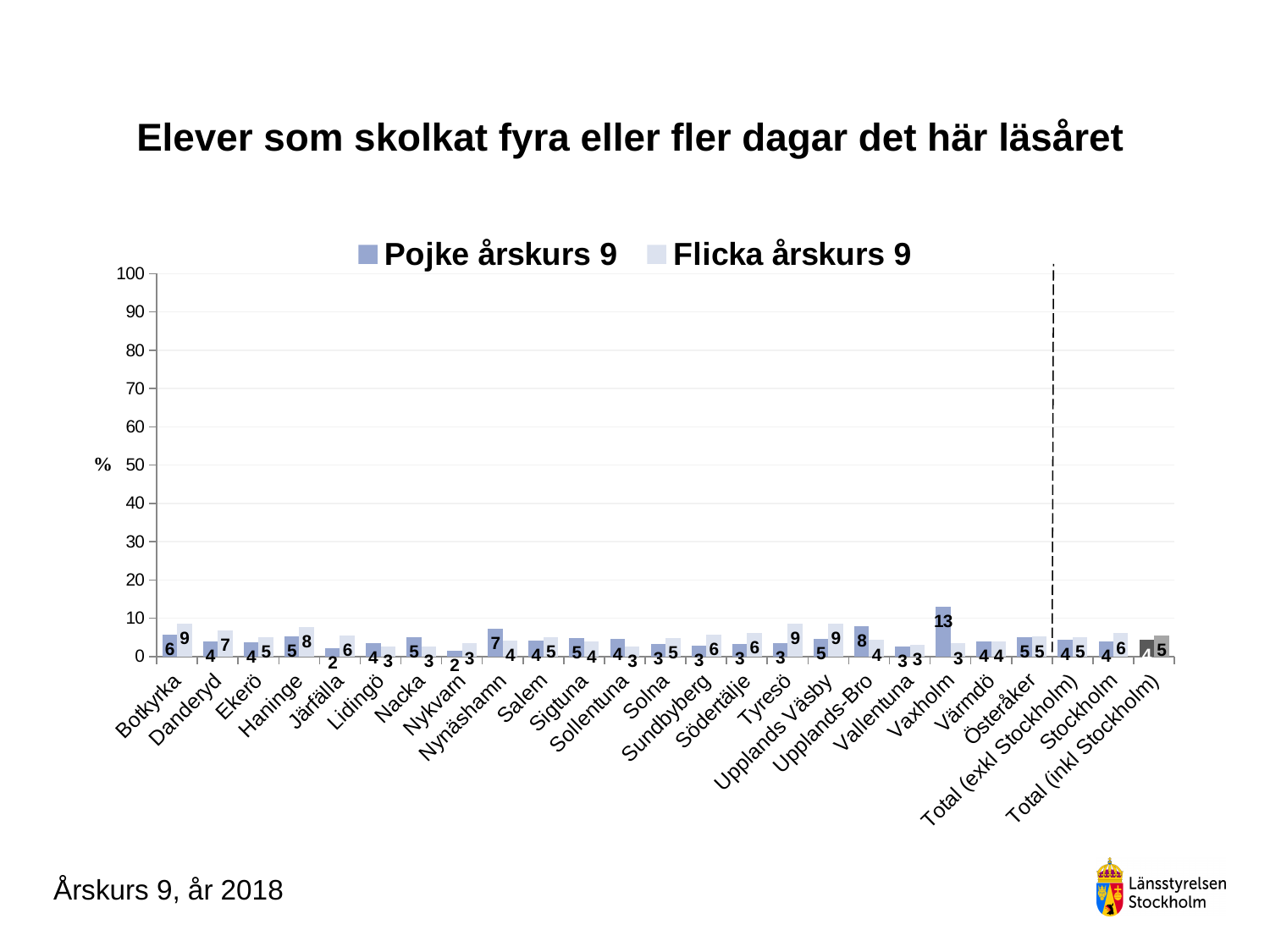
What is the difference between the Pojke årskurs 9 and Flicka årskurs 9 values in Vaxholm? 10 What kind of chart is shown on the slide? Bar chart What is the value for Flicka årskurs 9 in Stockholm? 6 What is the value for Flicka årskurs 9 in Botkyrka? 9 What is the value for Pojke årskurs 9 in Upplands-Bro? 8 How many series does the legend list? 2 How many categories are shown on the x axis? 25 Is the value for Pojke årskurs 9 in Vaxholm greater or less than 10? greater In Järfälla, which is larger: the Pojke årskurs 9 value or the Flicka årskurs 9 value? Flicka årskurs 9 What is the value for Pojke årskurs 9 in Vaxholm? 13 Which municipality has the highest value for Pojke årskurs 9? Vaxholm What is the difference between the Flicka årskurs 9 and Pojke årskurs 9 values in Tyresö? 6